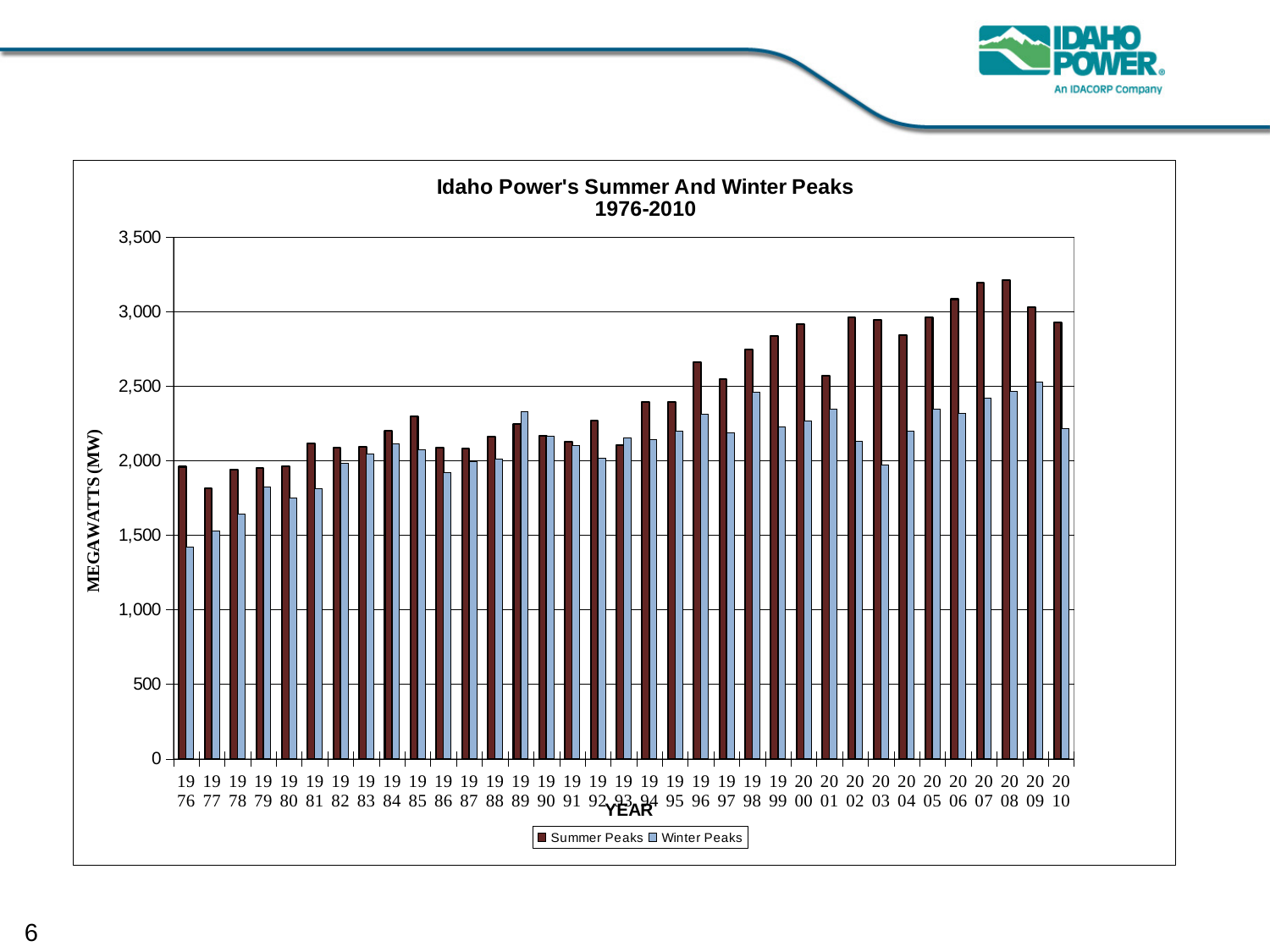
Which year has the lowest Summer Peaks value? 1977 How many series does the legend list? 2 What kind of chart is shown on the slide? bar chart Is the Summer Peaks value for 2007 greater or less than 3,000? greater How many years are plotted along the x axis? 35 Is the Summer Peaks value for 2010 greater or less than 2,500? greater Which year has the highest Winter Peaks value? 2009 In 2010, which is larger, the Summer Peaks value or the Winter Peaks value? Summer Peaks What are the two series named in the legend? Summer Peaks and Winter Peaks Is the Winter Peaks value for 1976 greater or less than 1,500? less Do the Summer Peaks values generally rise or fall from 1976 to 2010? rise Which year has the lowest Winter Peaks value? 1976